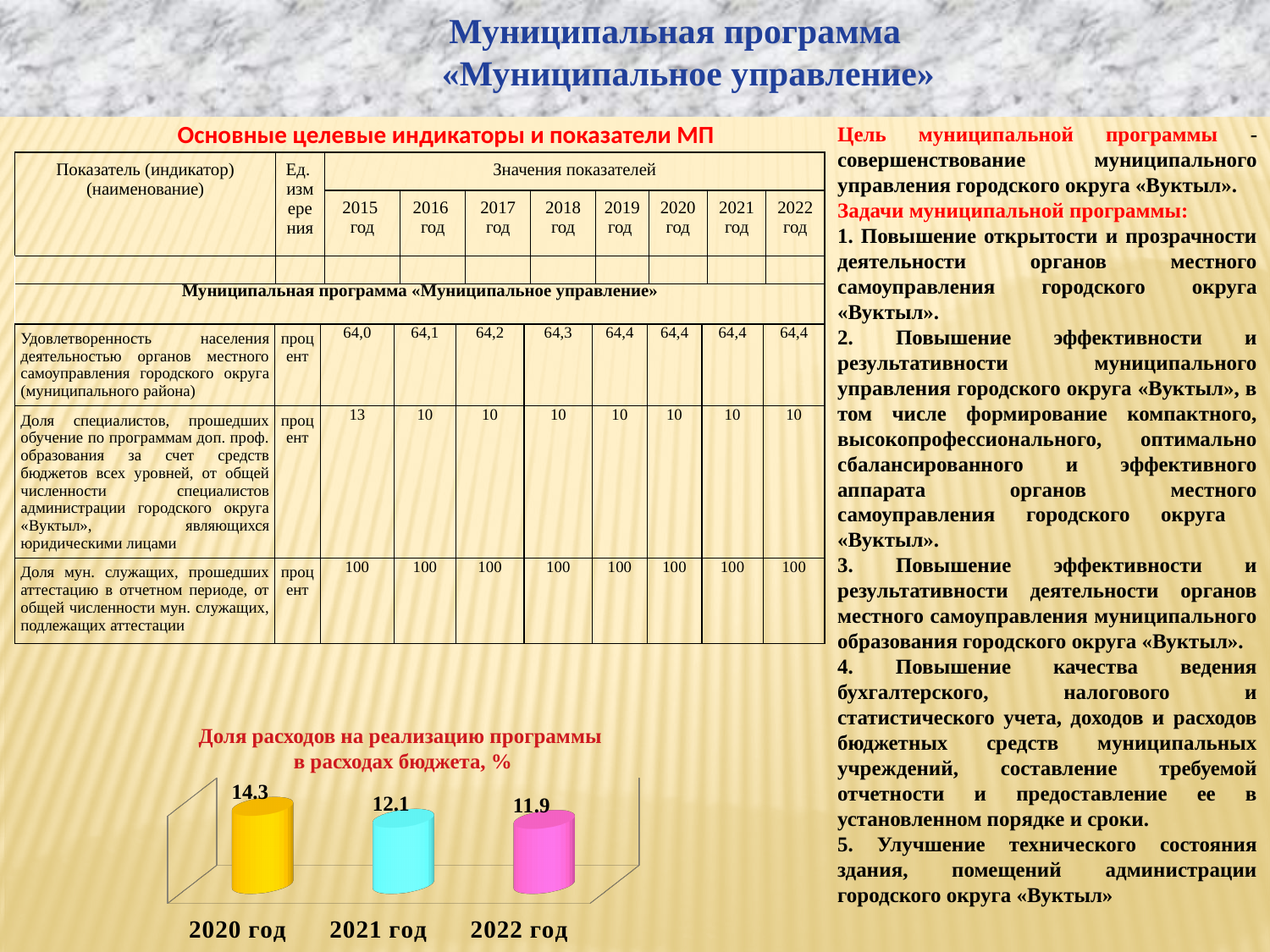
Do the values in the chart "Доля расходов на реализацию программы в расходах бюджета, %" rise or fall from 2020 год to 2022 год? fall What is the difference between the values for 2020 год and 2021 год in the chart "Доля расходов на реализацию программы в расходах бюджета, %"? 2.2 What is the value for 2020 год in the chart "Доля расходов на реализацию программы в расходах бюджета, %"? 14.3 What kind of chart is "Доля расходов на реализацию программы в расходах бюджета, %"? bar chart Which year has the highest value in the chart "Доля расходов на реализацию программы в расходах бюджета, %"? 2020 год What is the value for 2022 год in the chart "Доля расходов на реализацию программы в расходах бюджета, %"? 11.9 How many years (categories) are shown in the chart "Доля расходов на реализацию программы в расходах бюджета, %"? 3 What is the difference between the values for 2020 год and 2022 год in the chart "Доля расходов на реализацию программы в расходах бюджета, %"? 2.4 Which year has the lowest value in the chart "Доля расходов на реализацию программы в расходах бюджета, %"? 2022 год What is the value for 2021 год in the chart "Доля расходов на реализацию программы в расходах бюджета, %"? 12.1 What is the title of the chart at the bottom of the slide? Доля расходов на реализацию программы в расходах бюджета, % In the chart "Доля расходов на реализацию программы в расходах бюджета, %", which is larger: the value for 2021 год or 2022 год? 2021 год